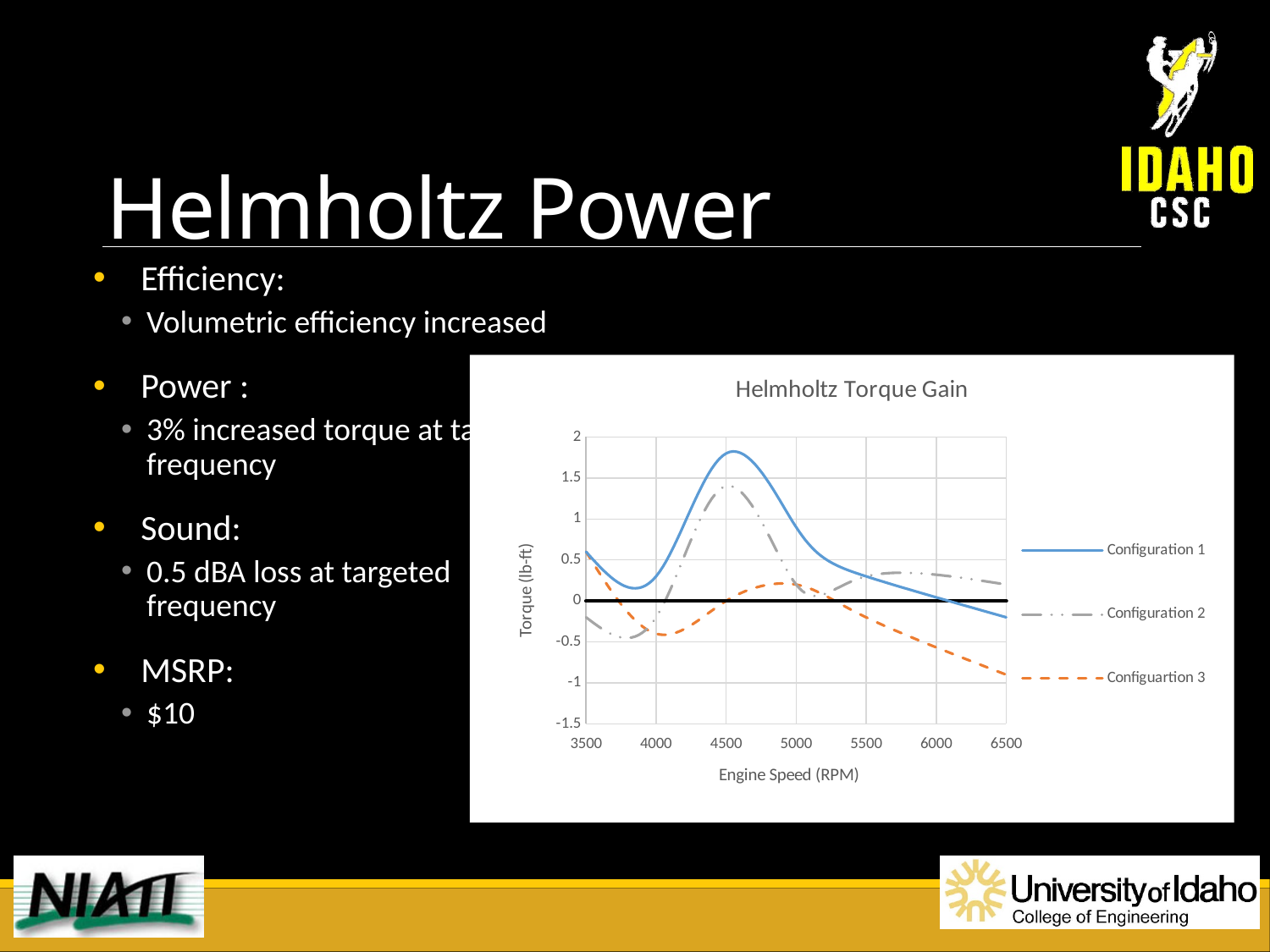
Which series reaches the highest torque value on the chart? Configuration 1 What is the title of the chart on the slide? Helmholtz Torque Gain Is the value for Configuration 1 at 4500 RPM greater or less than 1.5? greater Is the value for Configuration 2 at 4500 RPM greater or less than 1? greater Is the value for Configuartion 3 at 6500 RPM greater or less than -0.5? less What is the label of the x axis of the chart? Engine Speed (RPM) At 6500 RPM, which series has the larger value, Configuration 2 or Configuartion 3? Configuration 2 At 4500 RPM, which series has the larger value, Configuration 1 or Configuration 2? Configuration 1 Does the value for Configuartion 3 rise or fall from 5000 RPM to 6500 RPM? fall What type of chart is shown on the slide? line chart How many series does the legend of the Helmholtz Torque Gain chart list? 3